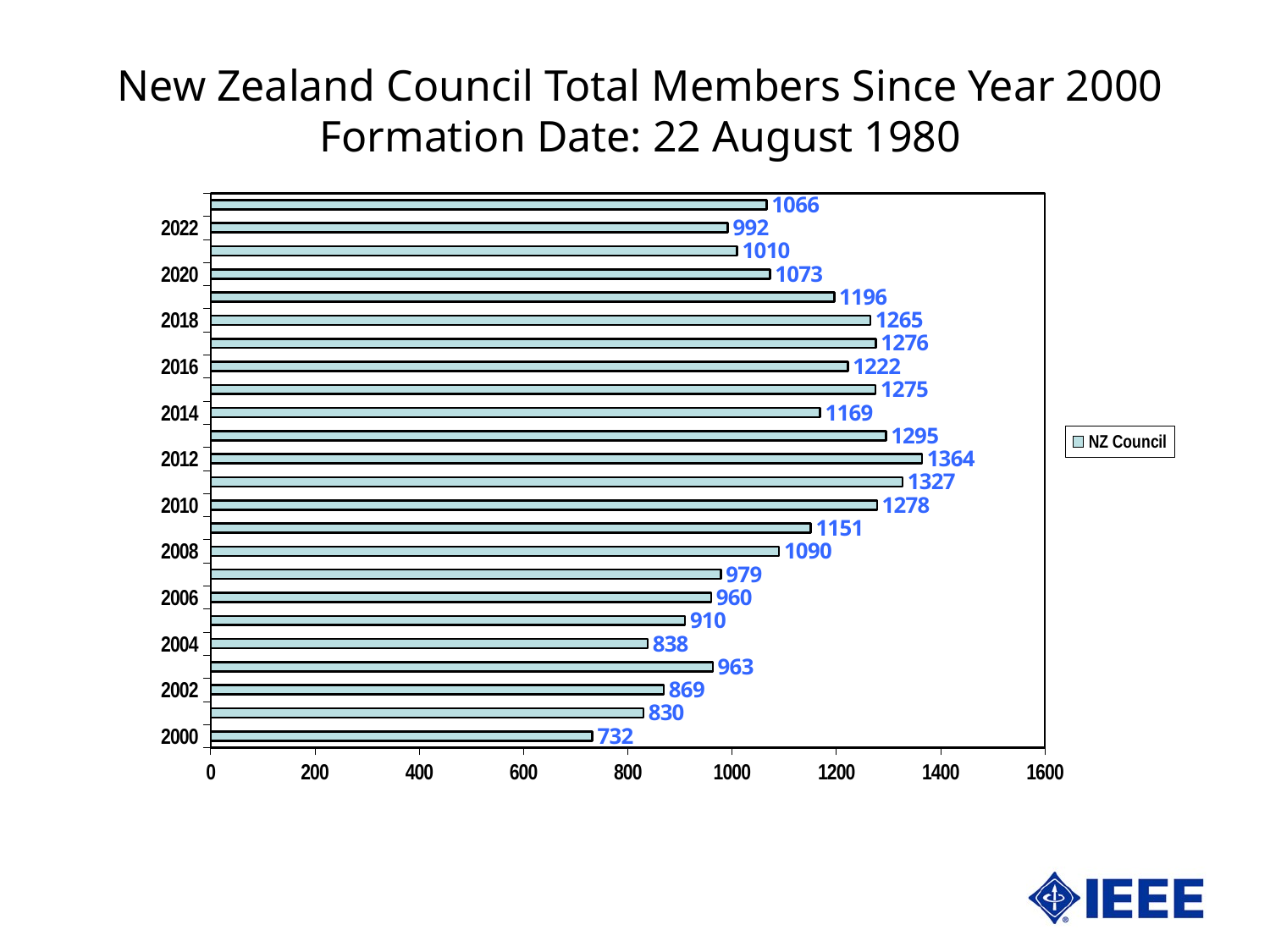
What is the difference between the values for 2012 and 2000? 632 How many bars are plotted in the chart? 24 How many series does the legend list? 1 What is the value for 2012? 1364 Which year has the lowest value? 2000 Which is larger, the value for 2010 or the value for 2016? 2010 What is the value for 2000? 732 What kind of chart is shown on the slide? bar chart Is the value for 2008 greater or less than 1000? greater What is the name of the series shown in the legend? NZ Council Which year has the highest value? 2012 What is the value for 2020? 1073